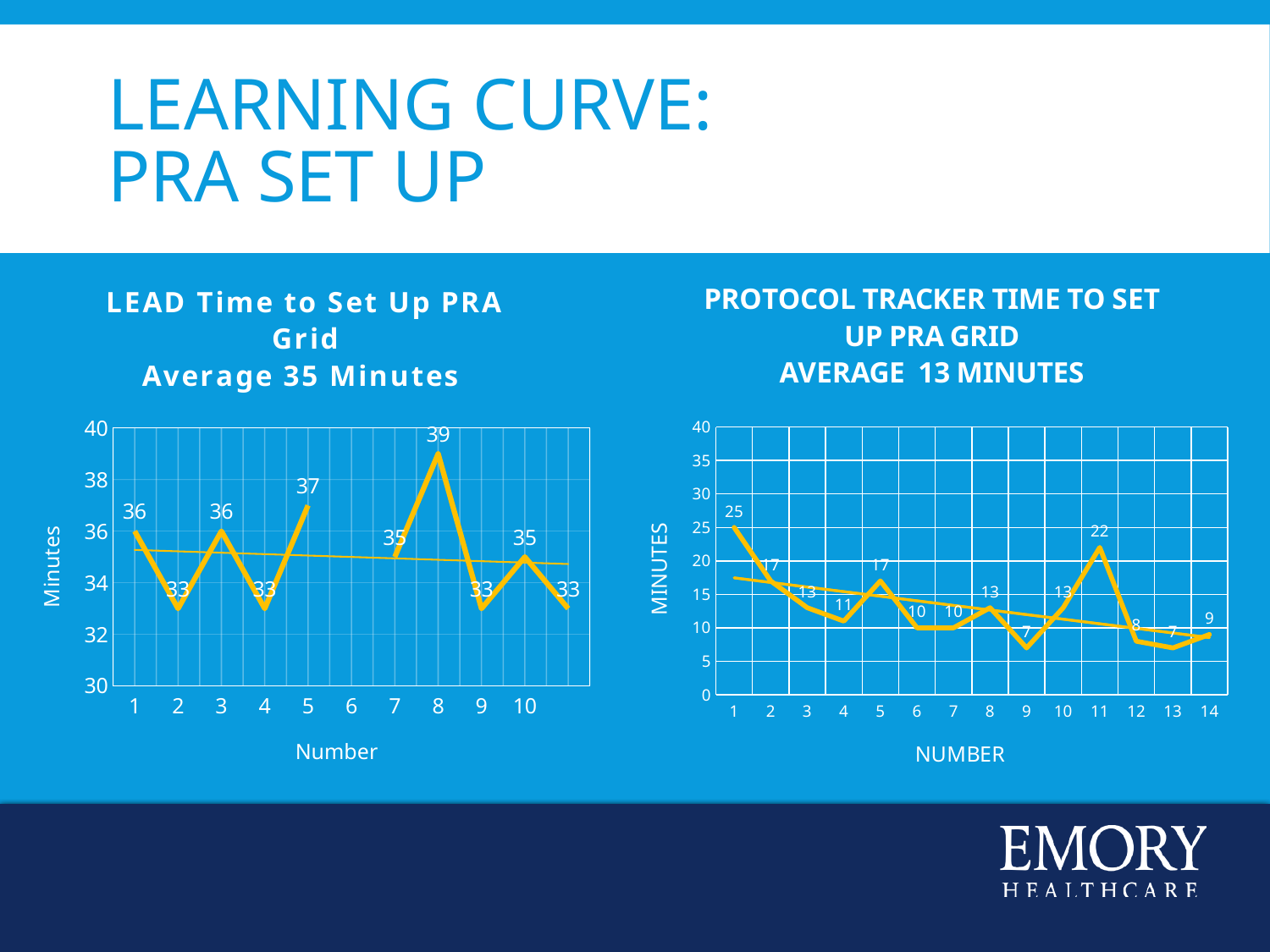
In the PROTOCOL TRACKER TIME TO SET UP PRA GRID chart on the right, do the values generally rise or fall from number 1 to number 14? Fall In the PROTOCOL TRACKER TIME TO SET UP PRA GRID chart on the right, what is the difference between the values for number 1 and number 14? 16 In the PROTOCOL TRACKER TIME TO SET UP PRA GRID chart on the right, which has the larger value, number 5 or number 6? Number 5 In the LEAD Time to Set Up PRA Grid chart on the left, which number has the highest value? 8 In the PROTOCOL TRACKER TIME TO SET UP PRA GRID chart on the right, how many numbers are plotted on the x axis? 14 In the LEAD Time to Set Up PRA Grid chart on the left, what is the value for number 5? 37 In the PROTOCOL TRACKER TIME TO SET UP PRA GRID chart on the right, what is the value for number 1? 25 In the PROTOCOL TRACKER TIME TO SET UP PRA GRID chart on the right, which number has the highest value? 1 In the PROTOCOL TRACKER TIME TO SET UP PRA GRID chart on the right, what is the value for number 11? 22 In the LEAD Time to Set Up PRA Grid chart on the left, what is the value for number 8? 39 What kind of chart is the LEAD Time to Set Up PRA Grid chart on the left? Line chart In the LEAD Time to Set Up PRA Grid chart on the left, what is the difference between the values for number 8 and number 9? 6